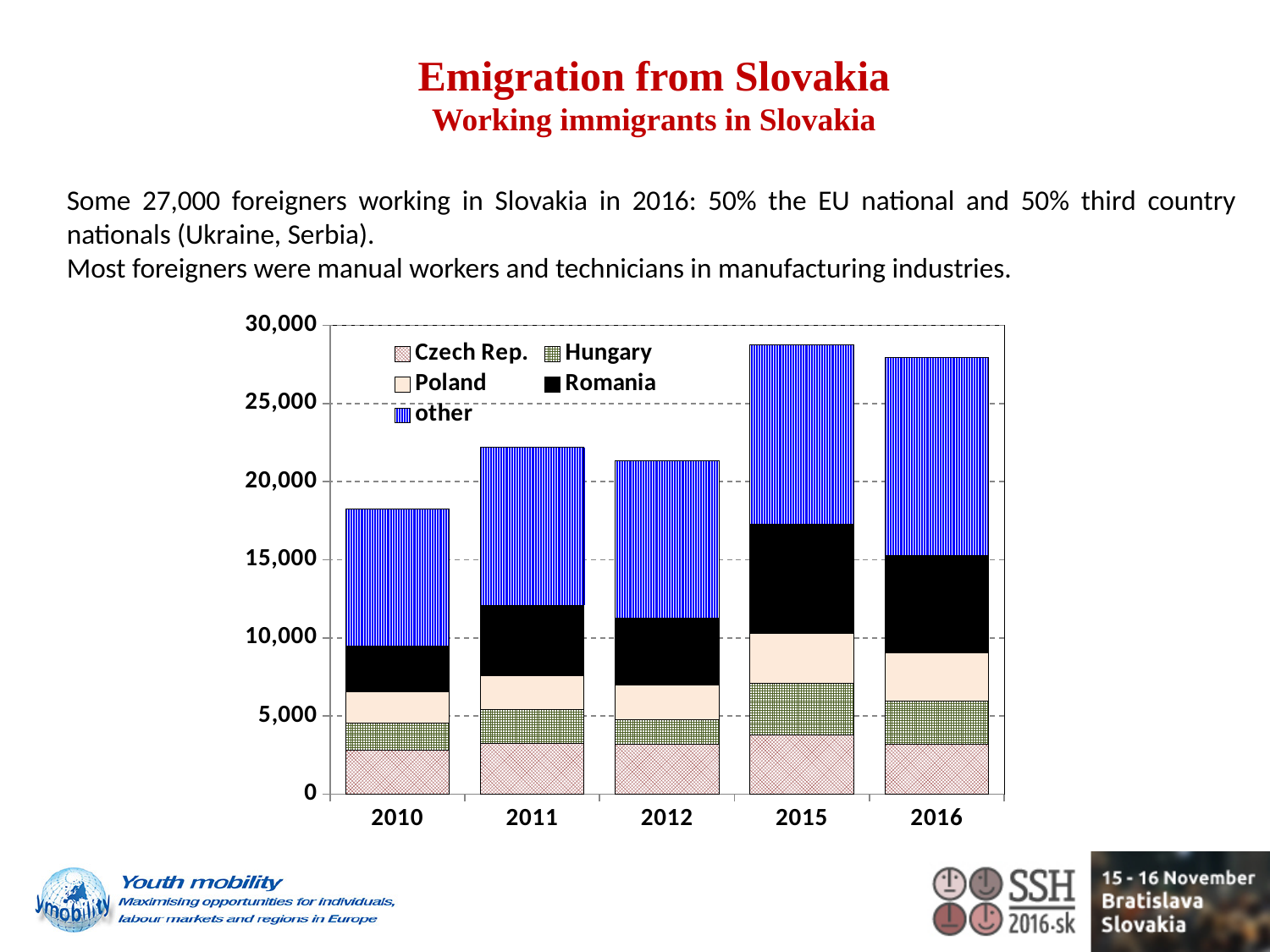
Is the total for 2010 greater or less than 20,000? less Which series is plotted at the top of each stacked bar? other Which series is plotted at the bottom of each stacked bar? Czech Rep. How many years are shown on the x axis of the chart? 5 Is the total for 2015 greater or less than 25,000? greater How many series does the chart's legend list? 5 Is the total for 2011 greater or less than 20,000? greater What kind of chart is shown on the slide? stacked bar chart Which total bar is larger, 2010 or 2015? 2015 Which year has the highest total bar in the chart? 2015 Which year has the lowest total bar in the chart? 2010